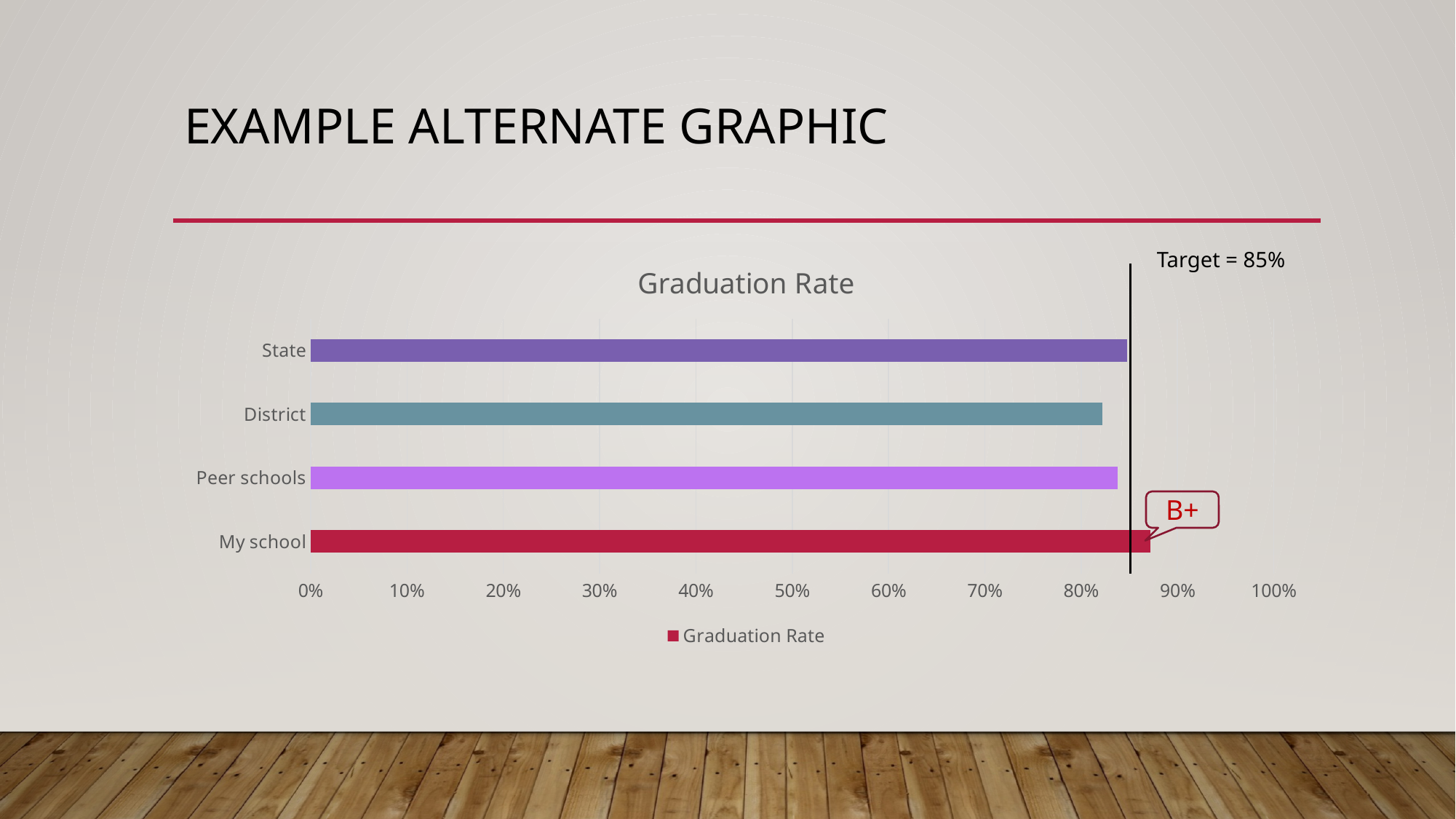
What kind of chart is shown on the slide? bar chart How many categories are plotted in the chart? 4 What target value is marked by the vertical line on the chart? 85% Is the value for State greater or less than 70%? greater Which is larger, the graduation rate for My school or for District? My school How many series does the legend list? 1 Which is larger, the graduation rate for State or for District? State Which category has the highest graduation rate? My school What is the title of the chart? Graduation Rate Is the value for My school greater or less than 80%? greater Is the value for Peer schools greater or less than 90%? less